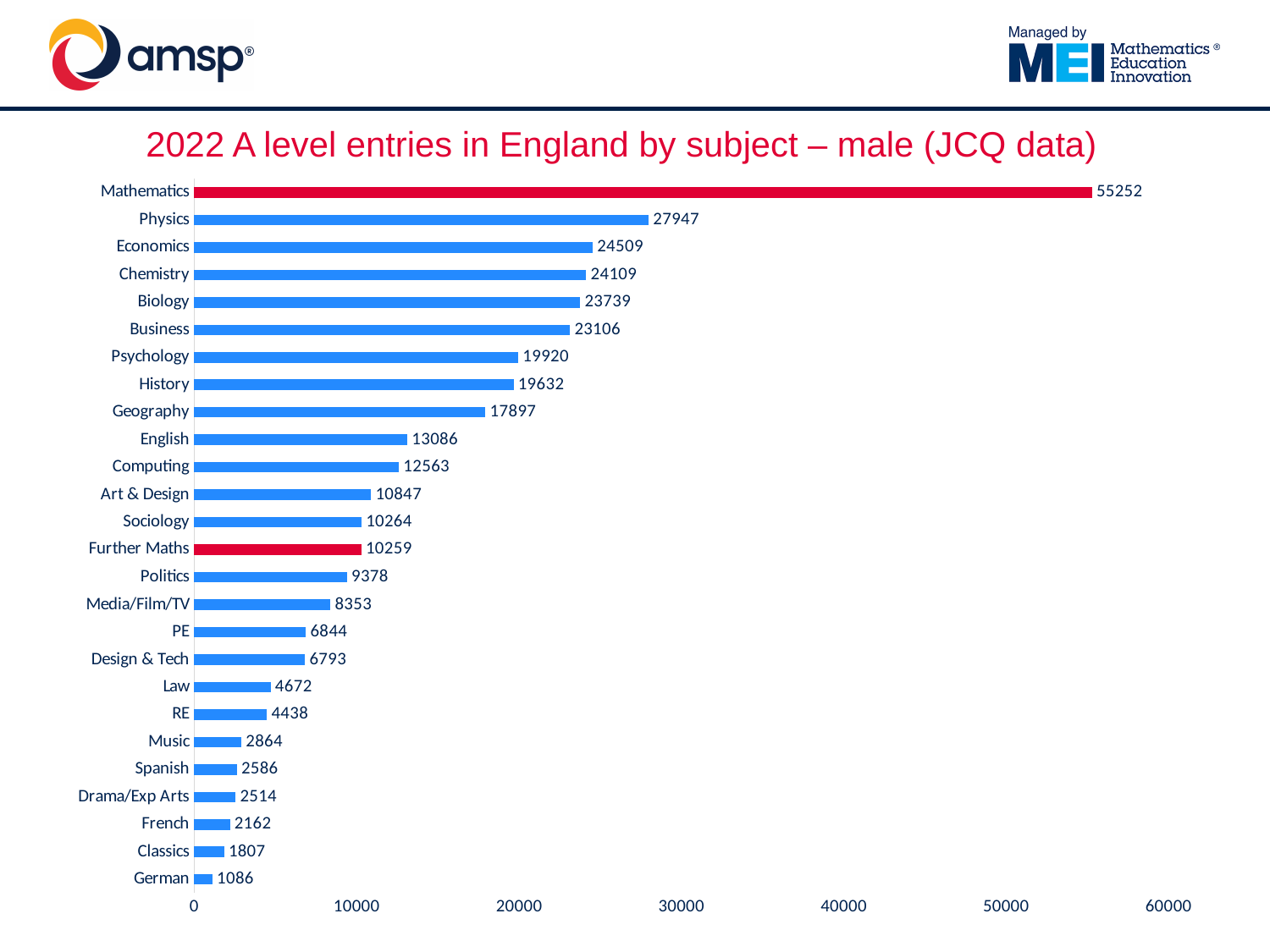
What is the difference between the values for Mathematics and Physics? 27305 What is the value for Further Maths? 10259 Which subject has the lowest number of entries? German How many subjects are shown in the chart? 26 What is the difference between the values for PE and Design & Tech? 51 Which subject has the highest number of entries? Mathematics Which two bars are coloured red rather than blue? Mathematics and Further Maths What kind of chart is shown on the slide? bar chart Is the value for Geography greater or less than 20000? less Which is larger, the value for Economics or the value for Chemistry? Economics What is the value for Physics? 27947 What is the value for Computing? 12563